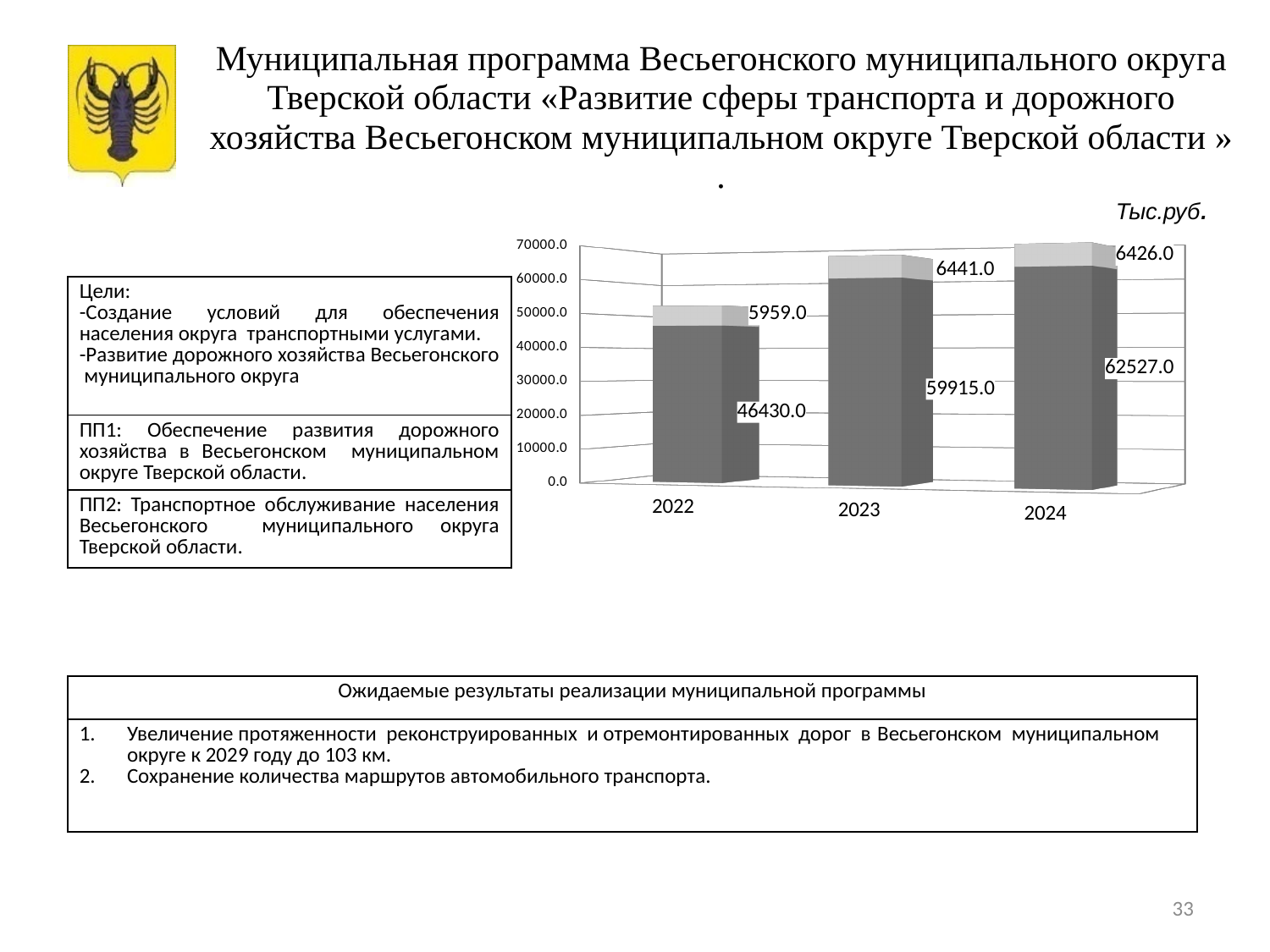
Which year has the highest value for the dark grey segment? 2024 What is the value of the dark grey segment for 2022? 46430.0 What is the total of the stacked bar for 2022? 52389.0 What is the value of the dark grey segment for 2024? 62527.0 How many years are shown on the x axis of the chart? 3 Which year has the lowest value for the dark grey segment? 2022 What is the value of the light grey top segment for 2022? 5959.0 What type of chart is shown on the slide? bar chart Do the dark grey segment values rise or fall from 2022 to 2024? rise What is the value of the dark grey segment for 2023? 59915.0 What is the difference between the dark grey segment values for 2024 and 2023? 2612.0 What is the value of the light grey top segment for 2023? 6441.0